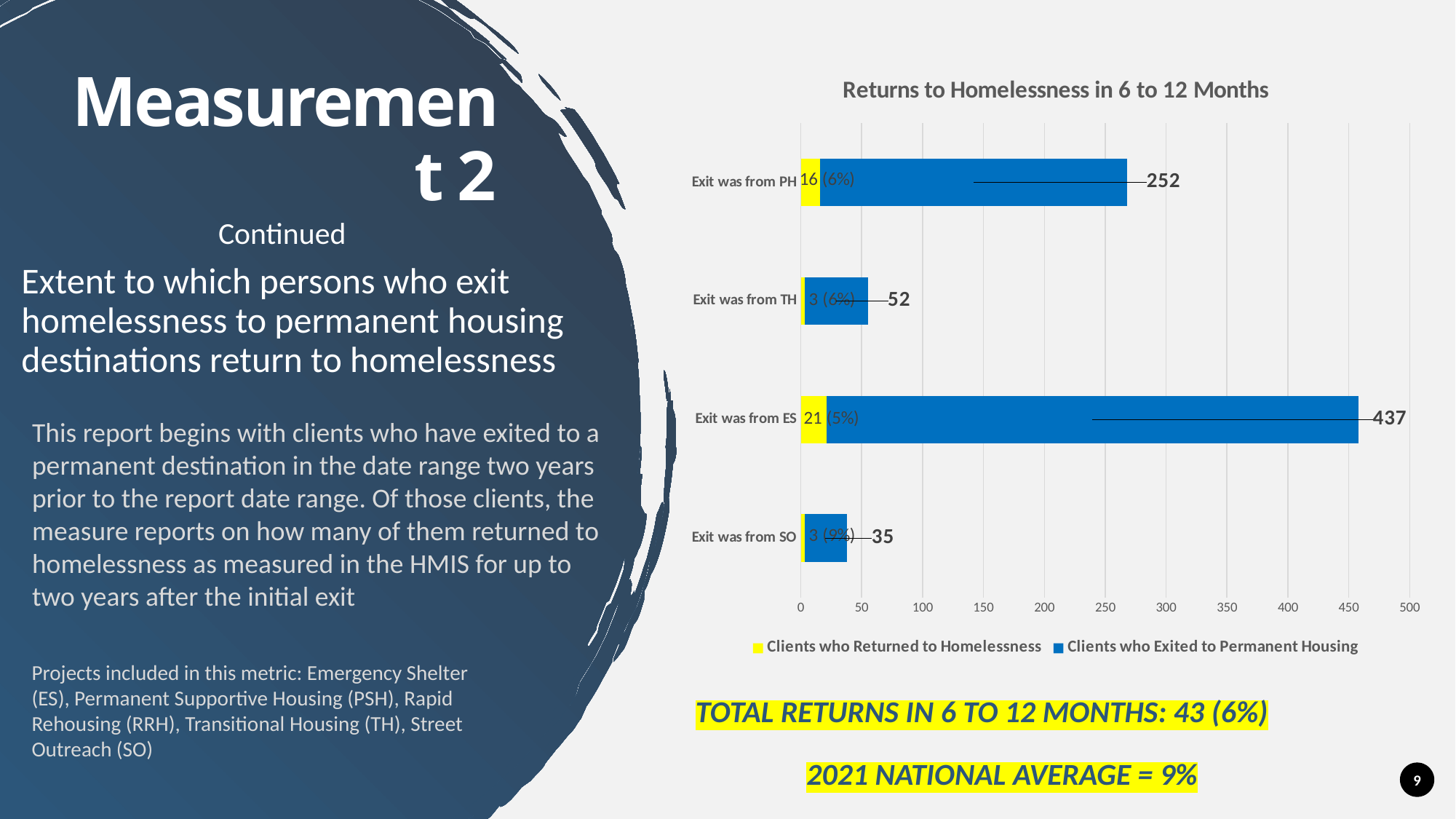
Which series is shown in yellow in the chart? Clients who Returned to Homelessness What is the difference between the clients who exited to permanent housing from ES and from PH? 185 Which has more clients who exited to permanent housing: 'Exit was from TH' or 'Exit was from SO'? Exit was from TH What is the title of the chart? Returns to Homelessness in 6 to 12 Months How many clients who exited to permanent housing are shown for 'Exit was from ES'? 437 Which exit category has the lowest number of clients who exited to permanent housing? Exit was from SO How many series does the chart legend list? 2 How many clients who returned to homelessness are shown for 'Exit was from PH'? 16 How many exit categories are plotted in the chart? 4 What percentage is shown next to the returned-to-homelessness value for 'Exit was from SO'? 9% What kind of chart is shown on the slide? bar chart Which exit category has the highest number of clients who exited to permanent housing? Exit was from ES